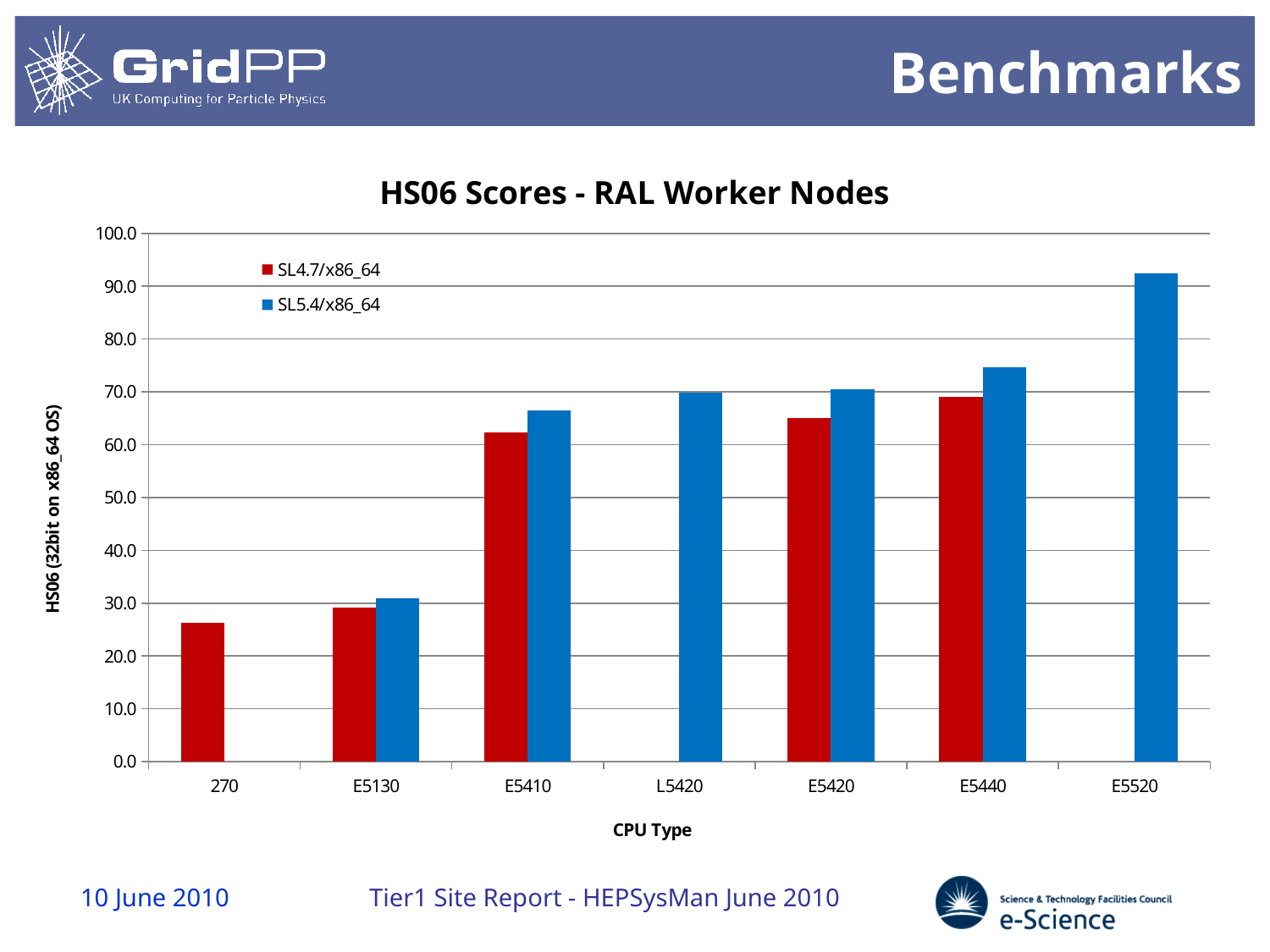
How many series does the legend list? 2 Is the SL4.7/x86_64 value for E5410 greater or less than 60? greater Which CPU type has the highest SL5.4/x86_64 score? E5520 Is the SL5.4/x86_64 value for E5520 greater or less than 90? greater Do the HS06 scores generally rise or fall moving from left to right along the x axis? rise Which CPU type has the lowest SL4.7/x86_64 score? 270 How many CPU types are shown on the x axis? 7 What type of chart is shown on the slide? bar chart Is the SL4.7/x86_64 value for 270 greater or less than 30? less Which is larger, the SL5.4/x86_64 value for E5440 or for E5410? E5440 What is the title of the chart? HS06 Scores - RAL Worker Nodes